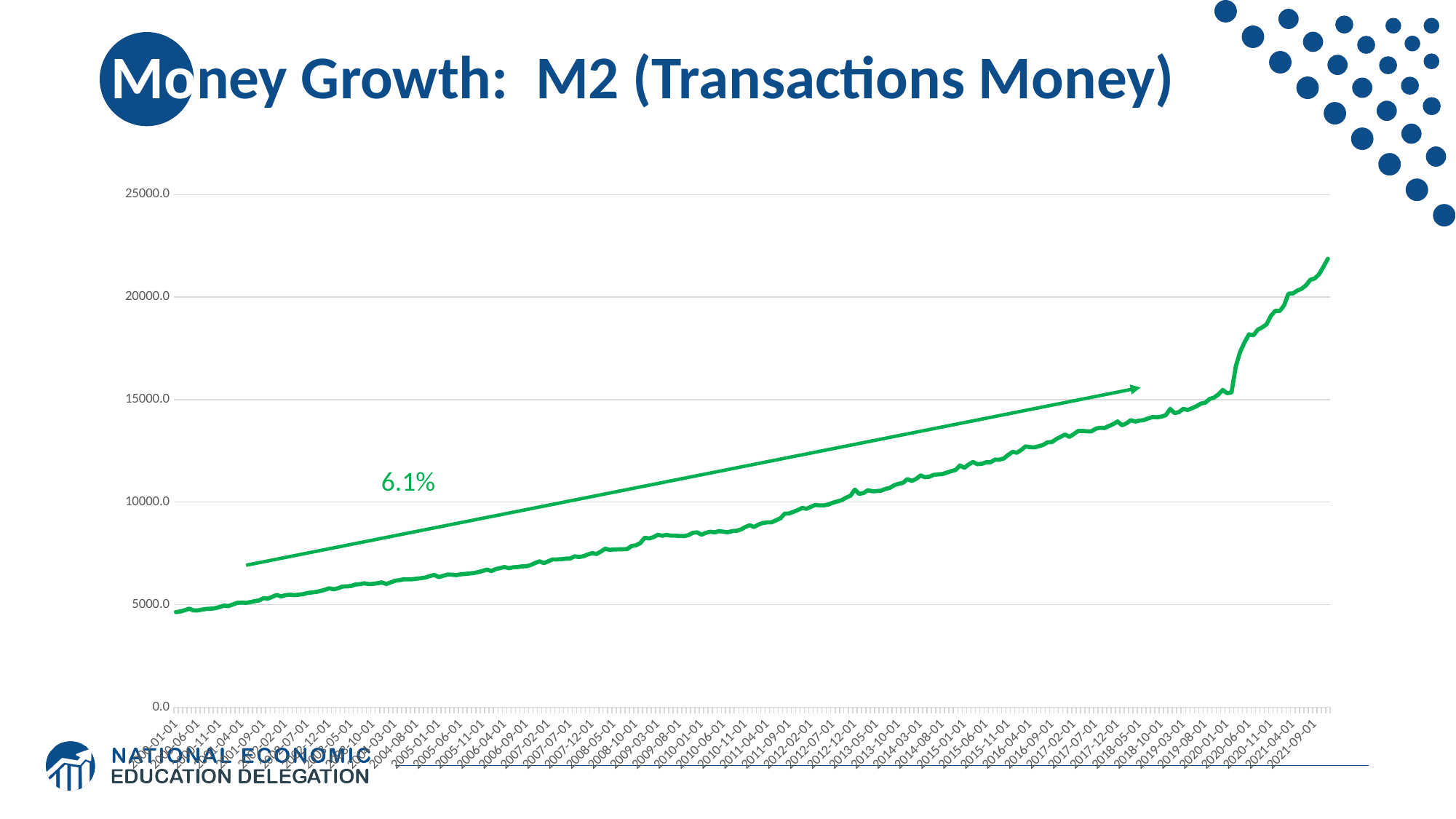
What is the title of the slide containing the chart? Money Growth: M2 (Transactions Money) Is the value for 2000-01-01 greater or less than 5000.0? less Is the value for 2008-10-01 greater or less than 10000.0? less Do the values on the chart generally rise or fall from left to right along the x axis? rise Is the value for 2016-04-01 greater or less than 15000.0? less Which has the larger value, 2000-01-01 or 2021-09-01? 2021-09-01 What kind of chart is shown on the slide? line chart At which end of the x axis does the line reach its highest value, the left (2000) or the right (2021)? right (2021) What growth rate is printed next to the straight trend arrow on the chart? 6.1%